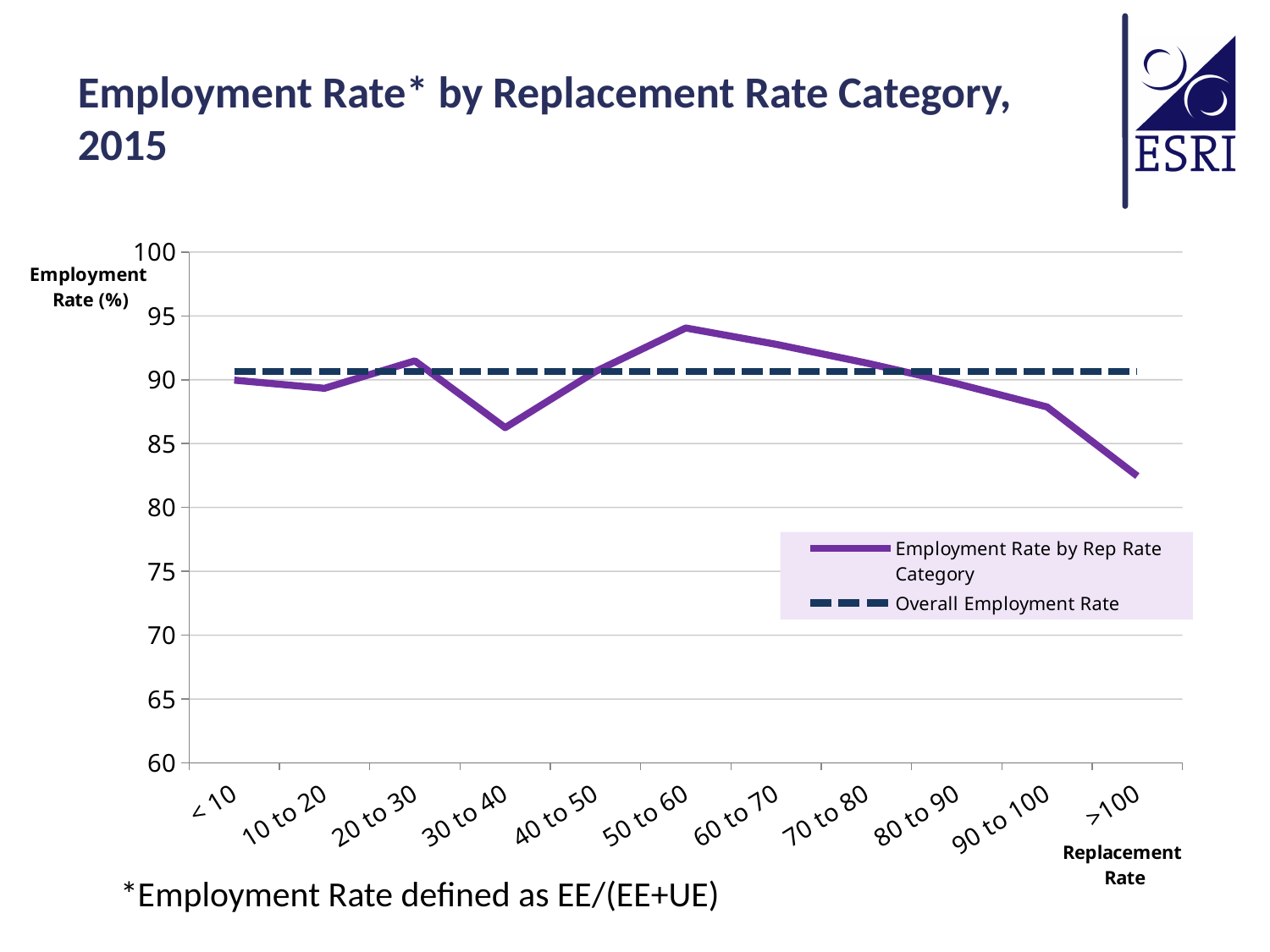
What kind of chart is shown on the slide? Line chart Does the employment rate rise or fall from the 50 to 60 category to the >100 category? Fall What does the dashed line in the chart represent? Overall Employment Rate How many series does the legend list? 2 Is the employment rate for the >100 category greater or less than 85? less Which replacement rate category has the highest employment rate? 50 to 60 What is the label on the vertical axis of the chart? Employment Rate (%) Which has the higher employment rate: the 20 to 30 category or the 30 to 40 category? 20 to 30 Is the employment rate for the 30 to 40 category greater or less than 90? less How many replacement rate categories are plotted along the x axis? 11 Is the employment rate for the 50 to 60 category greater or less than 90? greater Which replacement rate category has the lowest employment rate? >100